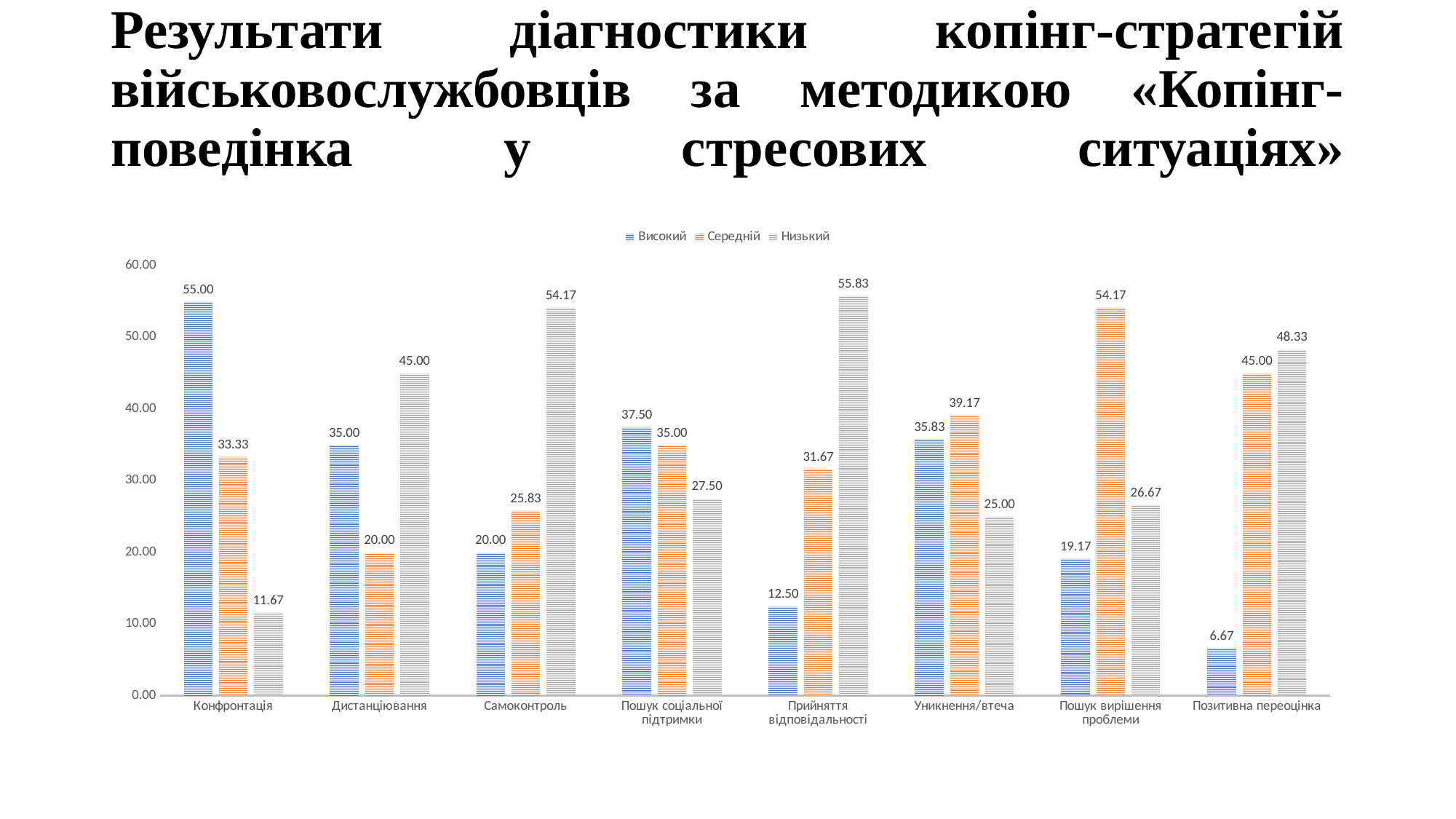
How many series does the legend list? 3 What is the value of the Низький series for Прийняття відповідальності? 55.83 How many categories are shown on the x axis? 8 Is the Низький value for Самоконтроль greater or less than 50.00? greater Which series is shown in orange in the legend? Середній What kind of chart is shown on the slide? bar chart What is the value of the Високий series for Конфронтація? 55.00 Which category has the highest value in the Низький series? Прийняття відповідальності What is the value of the Середній series for Пошук вирішення проблеми? 54.17 What is the difference between the Низький and Високий values for Дистанціювання? 10.00 For Уникнення/втеча, which is larger: the Високий value or the Середній value? Середній Which category has the lowest value in the Високий series? Позитивна переоцінка